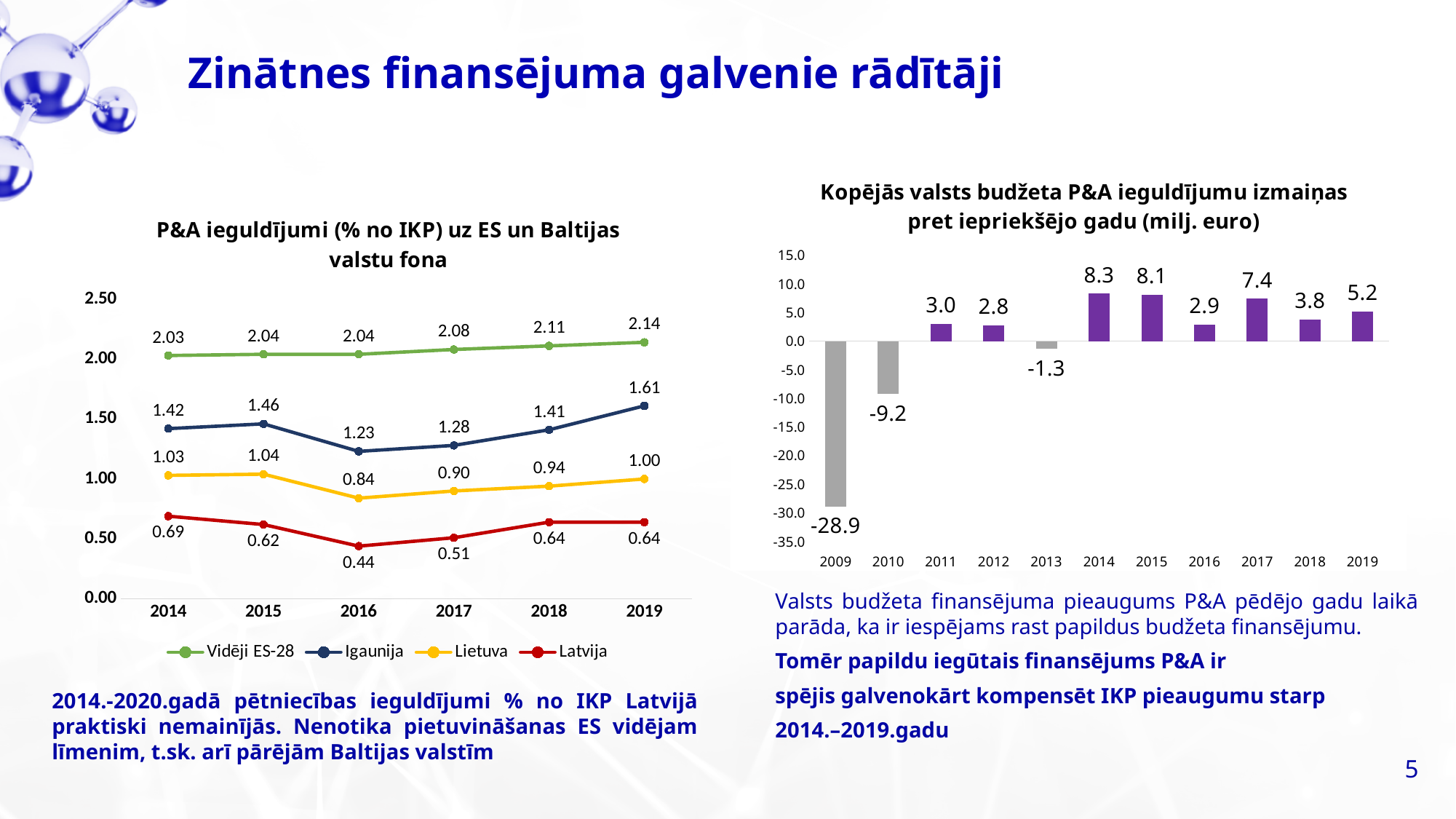
In the right chart 'Kopējās valsts budžeta P&A ieguldījumu izmaiņas pret iepriekšējo gadu (milj. euro)', what kind of chart is it? Bar chart In the left chart 'P&A ieguldījumi (% no IKP) uz ES un Baltijas valstu fona', what is the difference between Vidēji ES-28 and Latvija in 2019? 1.50 In the left chart 'P&A ieguldījumi (% no IKP) uz ES un Baltijas valstu fona', what is the value for Latvija in 2016? 0.44 In the left chart 'P&A ieguldījumi (% no IKP) uz ES un Baltijas valstu fona', what kind of chart is it? Line chart In the right chart 'Kopējās valsts budžeta P&A ieguldījumu izmaiņas pret iepriekšējo gadu (milj. euro)', which year has the lowest value? 2009 In the right chart 'Kopējās valsts budžeta P&A ieguldījumu izmaiņas pret iepriekšējo gadu (milj. euro)', what is the difference between the values for 2017 and 2018? 3.6 In the left chart 'P&A ieguldījumi (% no IKP) uz ES un Baltijas valstu fona', how many series does the legend list? 4 In the right chart 'Kopējās valsts budžeta P&A ieguldījumu izmaiņas pret iepriekšējo gadu (milj. euro)', how many years are shown? 11 In the right chart 'Kopējās valsts budžeta P&A ieguldījumu izmaiņas pret iepriekšējo gadu (milj. euro)', which year has the highest value? 2014 In the left chart 'P&A ieguldījumi (% no IKP) uz ES un Baltijas valstu fona', which series has the lowest value in 2018? Latvija In the left chart 'P&A ieguldījumi (% no IKP) uz ES un Baltijas valstu fona', what is the value for Igaunija in 2019? 1.61 In the right chart 'Kopējās valsts budžeta P&A ieguldījumu izmaiņas pret iepriekšējo gadu (milj. euro)', what is the value for 2014? 8.3